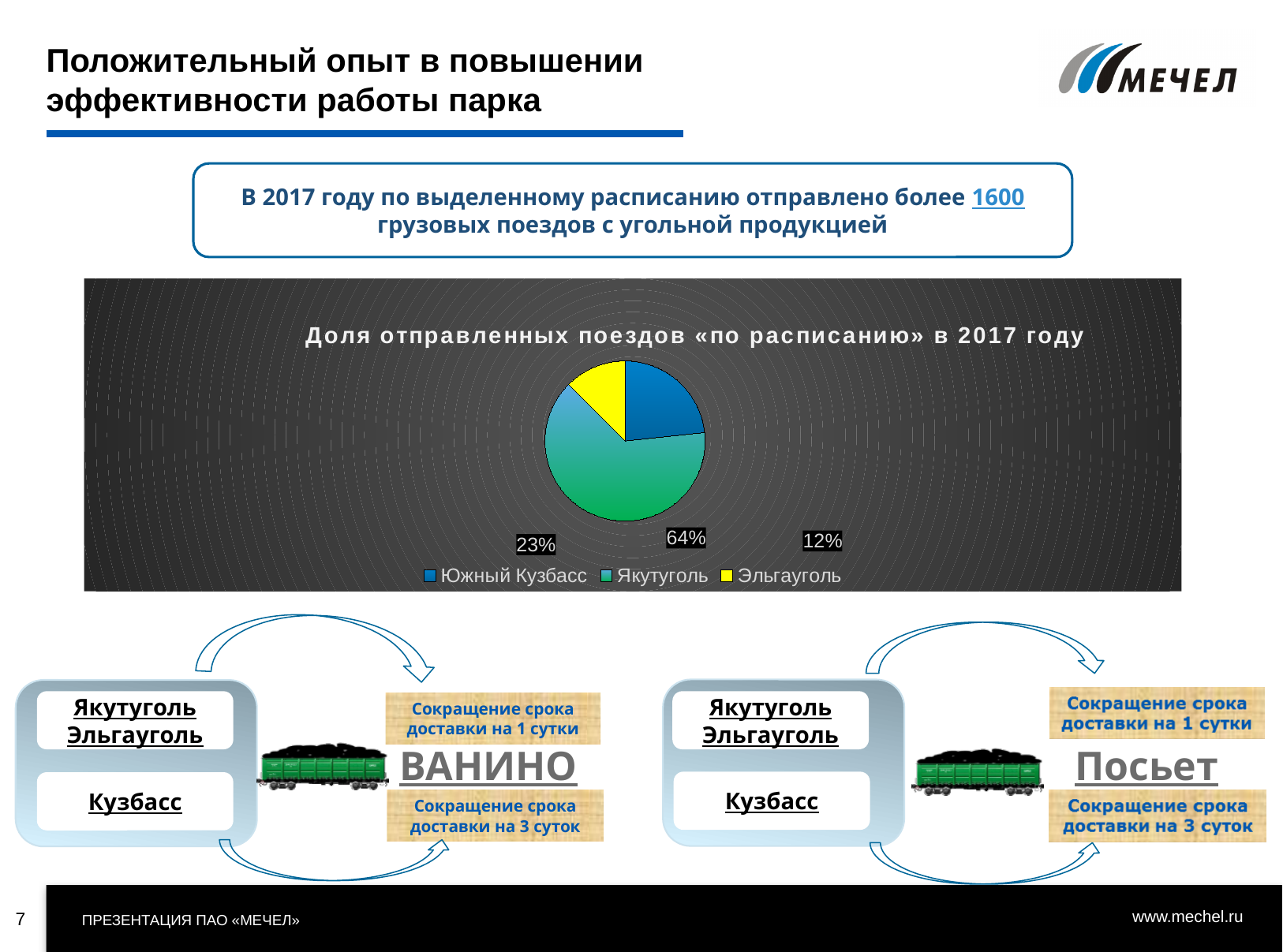
What share of the pie does Эльгауголь account for? 12% What kind of chart is shown on the slide? pie chart What is the title of the pie chart? Доля отправленных поездов «по расписанию» в 2017 году What share of the pie does Южный Кузбасс account for? 23% How many slices does the pie chart have? 3 Which category has the smallest share in the pie chart? Эльгауголь What colour represents Эльгауголь in the pie chart? yellow Which is larger in the pie chart: the share of Южный Кузбасс or the share of Эльгауголь? Южный Кузбасс By how many percentage points does the share of Якутуголь exceed the share of Южный Кузбасс? 41 Which category has the largest share in the pie chart? Якутуголь What share of the pie does Якутуголь account for? 64% How many entries does the legend of the pie chart list? 3